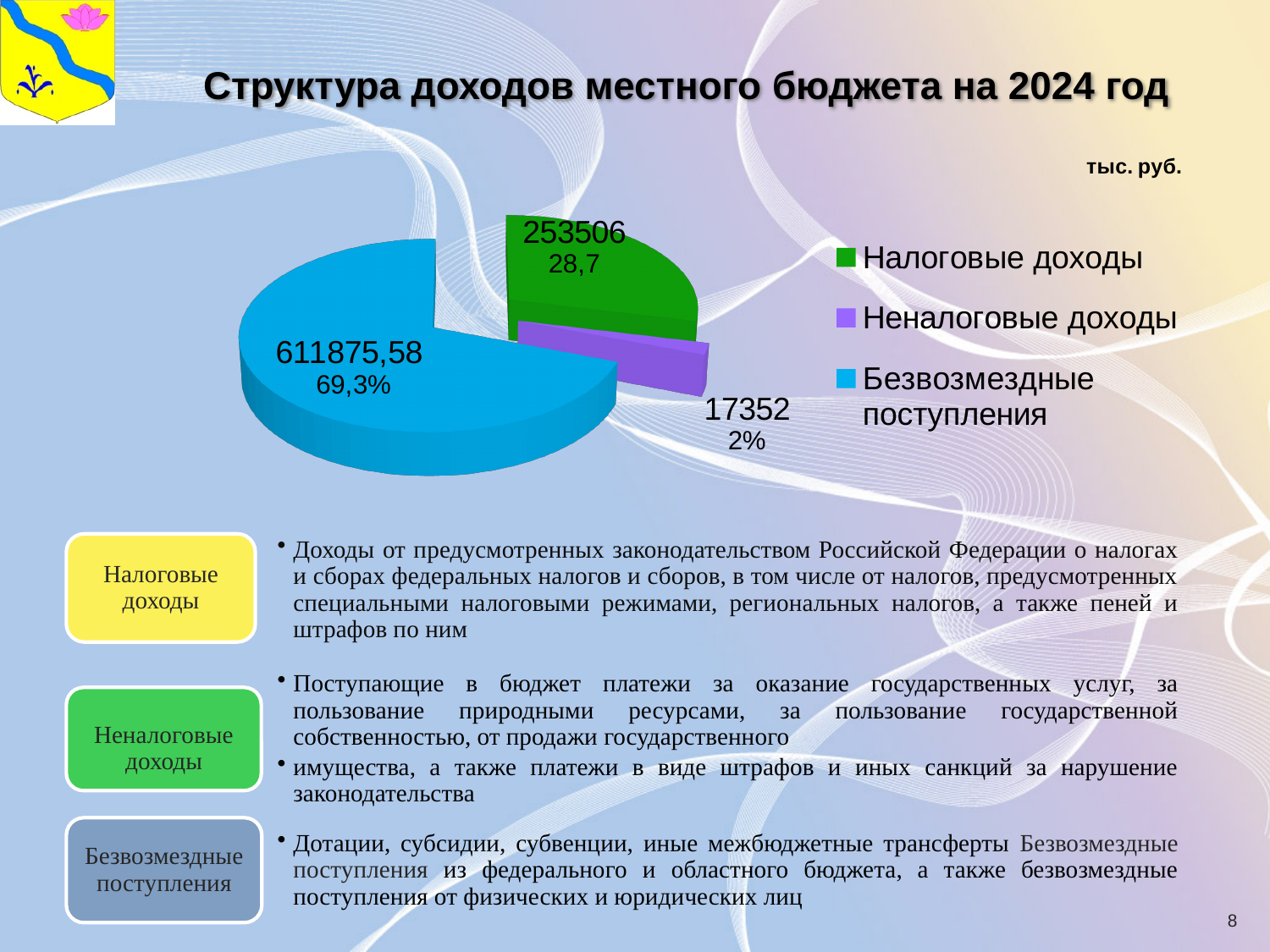
What is the value for Безвозмездные поступления in the pie chart? 611875,58 Which category has the largest slice in the pie chart? Безвозмездные поступления What is the title of the chart on the slide? Структура доходов местного бюджета на 2024 год What is the difference between the values for Безвозмездные поступления and Налоговые доходы? 358369,58 Which is larger, Налоговые доходы or Неналоговые доходы? Налоговые доходы How many categories does the pie chart have? 3 What type of chart is shown on the slide? pie chart What is the value for Неналоговые доходы in the pie chart? 17352 What is the value for Налоговые доходы in the pie chart? 253506 Which category has the smallest slice in the pie chart? Неналоговые доходы What share of the pie does Неналоговые доходы represent? 2% What share of the pie does Безвозмездные поступления represent? 69,3%